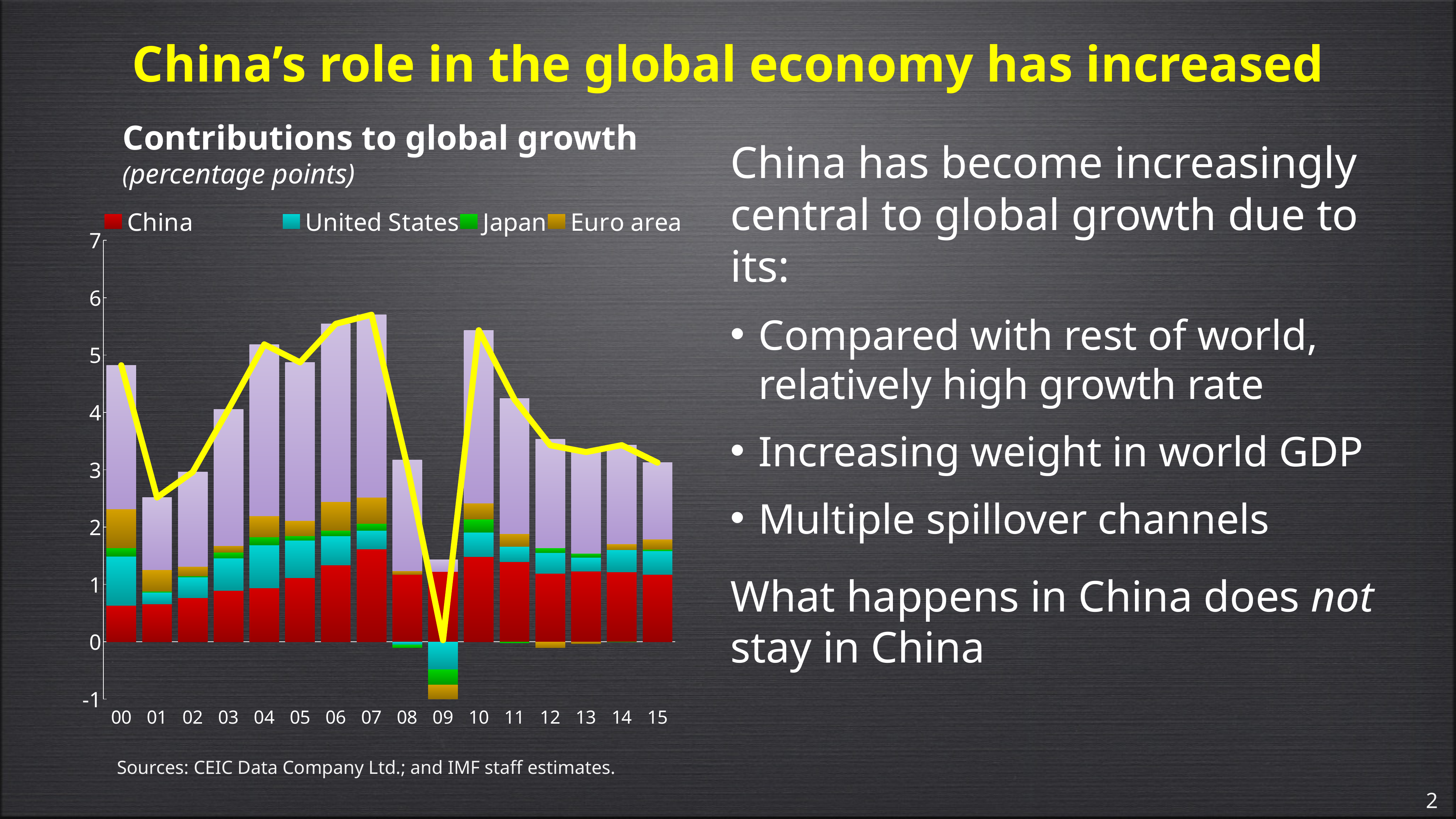
In what units are the values in the chart expressed? percentage points In which year does the yellow line reach its lowest value? 09 What is the title of the chart? Contributions to global growth What kind of chart is shown on the slide? stacked bar chart with a line How many years are shown on the x axis of the chart? 16 Is the value of the yellow line in 07 greater or less than 5? greater How many series does the chart's legend list? 4 Between 01 and 07, does the yellow line generally rise or fall? rise Is China's contribution in 07 greater or less than 1? greater Which is larger, China's contribution in 07 or in 00? 07 Is China's contribution in 00 greater or less than 1? less